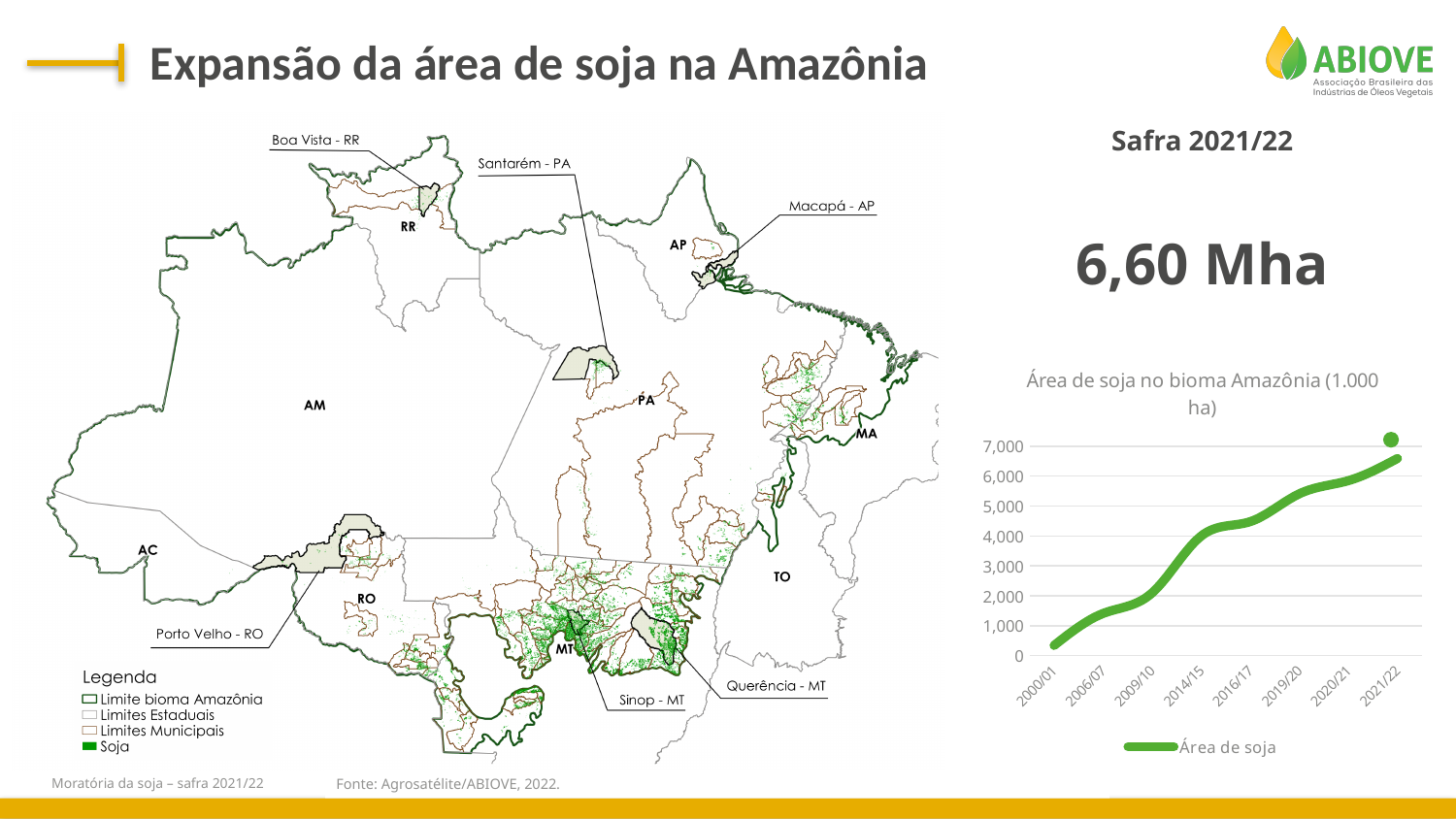
In the 'Área de soja no bioma Amazônia' chart, which season has the highest value? 2021/22 In the 'Área de soja no bioma Amazônia' chart, is the value for 2021/22 greater or less than 6,000? greater In the 'Área de soja no bioma Amazônia' chart, which season has the lowest value? 2000/01 How many series does the legend of the 'Área de soja no bioma Amazônia' chart list? 1 In the 'Área de soja no bioma Amazônia' chart, is the value for 2000/01 greater or less than 1,000? less In the 'Área de soja no bioma Amazônia' chart, which is larger, the value for 2021/22 or the value for 2009/10? 2021/22 How many season labels are shown on the x axis of the 'Área de soja no bioma Amazônia' chart? 8 In the 'Área de soja no bioma Amazônia' chart, do the values rise or fall from 2000/01 to 2021/22? rise What is the name of the series shown in the legend of the 'Área de soja no bioma Amazônia' chart? Área de soja In the 'Área de soja no bioma Amazônia' chart, is the value for 2019/20 greater or less than 5,000? greater What kind of chart is the 'Área de soja no bioma Amazônia (1.000 ha)' chart? line chart